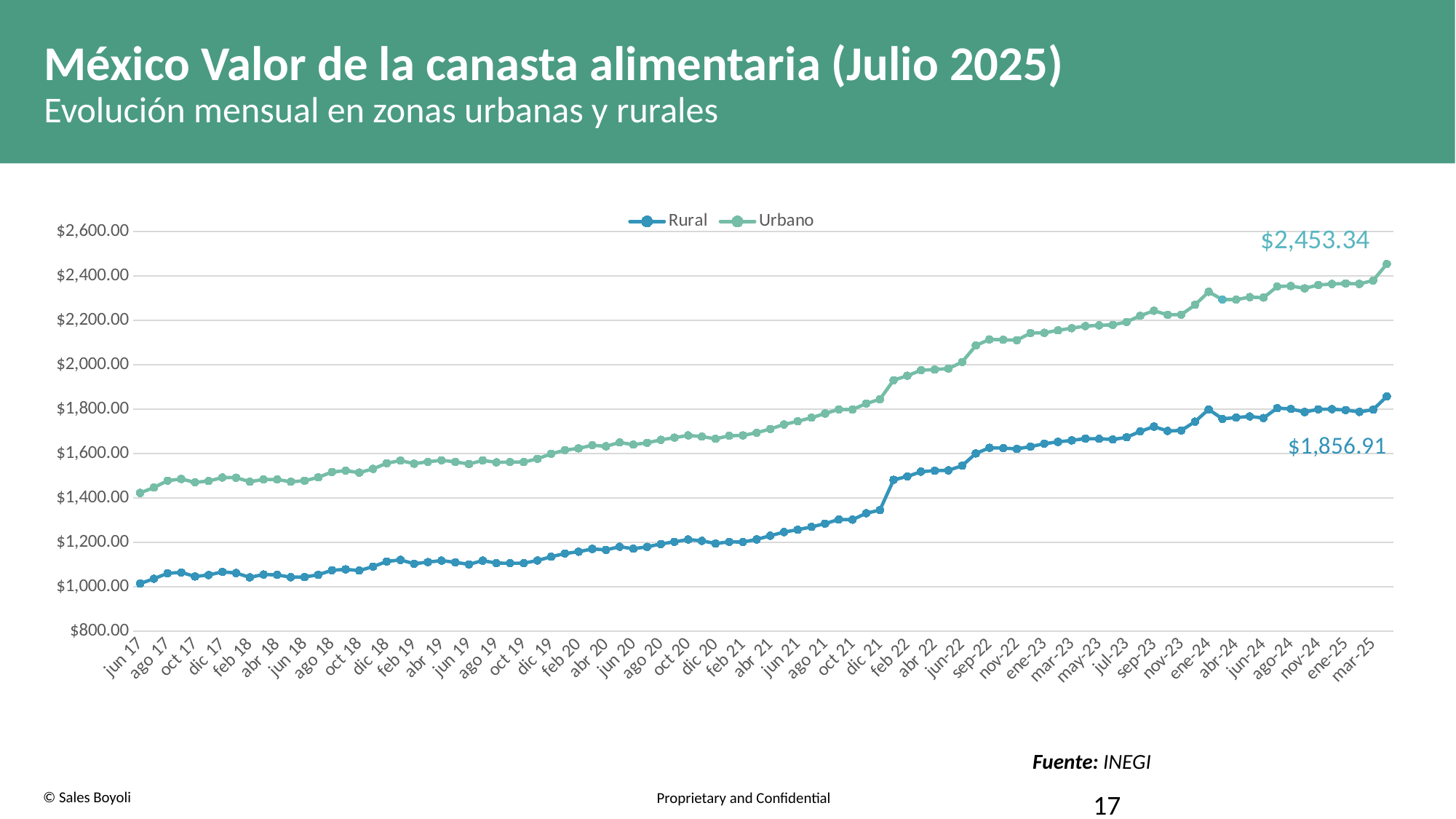
What kind of chart is shown on the slide? line chart What is the difference between the final labelled Urbano value and the final labelled Rural value? $596.43 Do the values of the Rural series generally rise or fall from jun 17 to the end of the chart? rise What are the two series named in the legend? Rural and Urbano Is the Urbano value for ene-24 greater or less than $2,200.00? greater Is the Rural value for jun 17 greater or less than $1,200.00? less What is the title of the chart slide? México Valor de la canasta alimentaria (Julio 2025) What is the final labelled value of the Urbano series? $2,453.34 How many series does the legend list? 2 Is the Urbano value for jun 17 greater or less than $1,600.00? less What is the final labelled value of the Rural series? $1,856.91 At the end of the series, which is higher, Urbano or Rural? Urbano